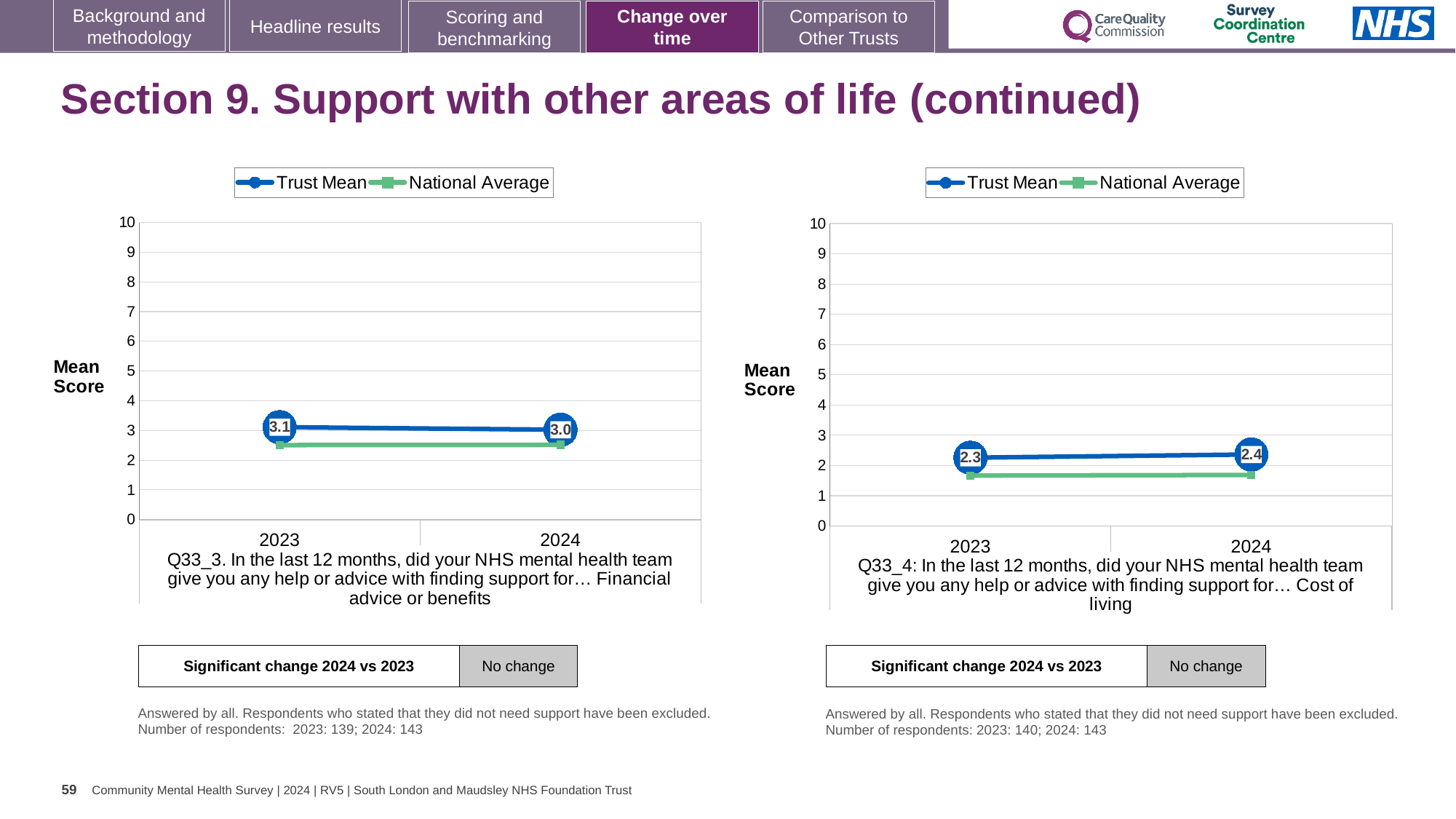
On the right chart (Q33_4), is the National Average value for 2023 greater or less than 2? less On the right chart (Q33_4, Cost of living), what is the Trust Mean score for 2023? 2.3 On the right chart (Q33_4, Cost of living), what is the Trust Mean score for 2024? 2.4 On the left chart (Q33_3), is the National Average value for 2024 greater or less than 3? less On the left chart (Q33_3), does the Trust Mean rise or fall from 2023 to 2024? fall On the left chart (Q33_3, Financial advice or benefits), what is the Trust Mean score for 2023? 3.1 On the right chart (Q33_4), does the Trust Mean rise or fall from 2023 to 2024? rise On the left chart (Q33_3), by how much did the Trust Mean change from 2023 to 2024? 0.1 How many series does the legend of the left chart list? 2 On the left chart (Q33_3, Financial advice or benefits), what is the Trust Mean score for 2024? 3.0 On the right chart (Q33_4), which series is higher in 2024, Trust Mean or National Average? Trust Mean What kind of chart is the right chart (Q33_4, Cost of living)? line chart